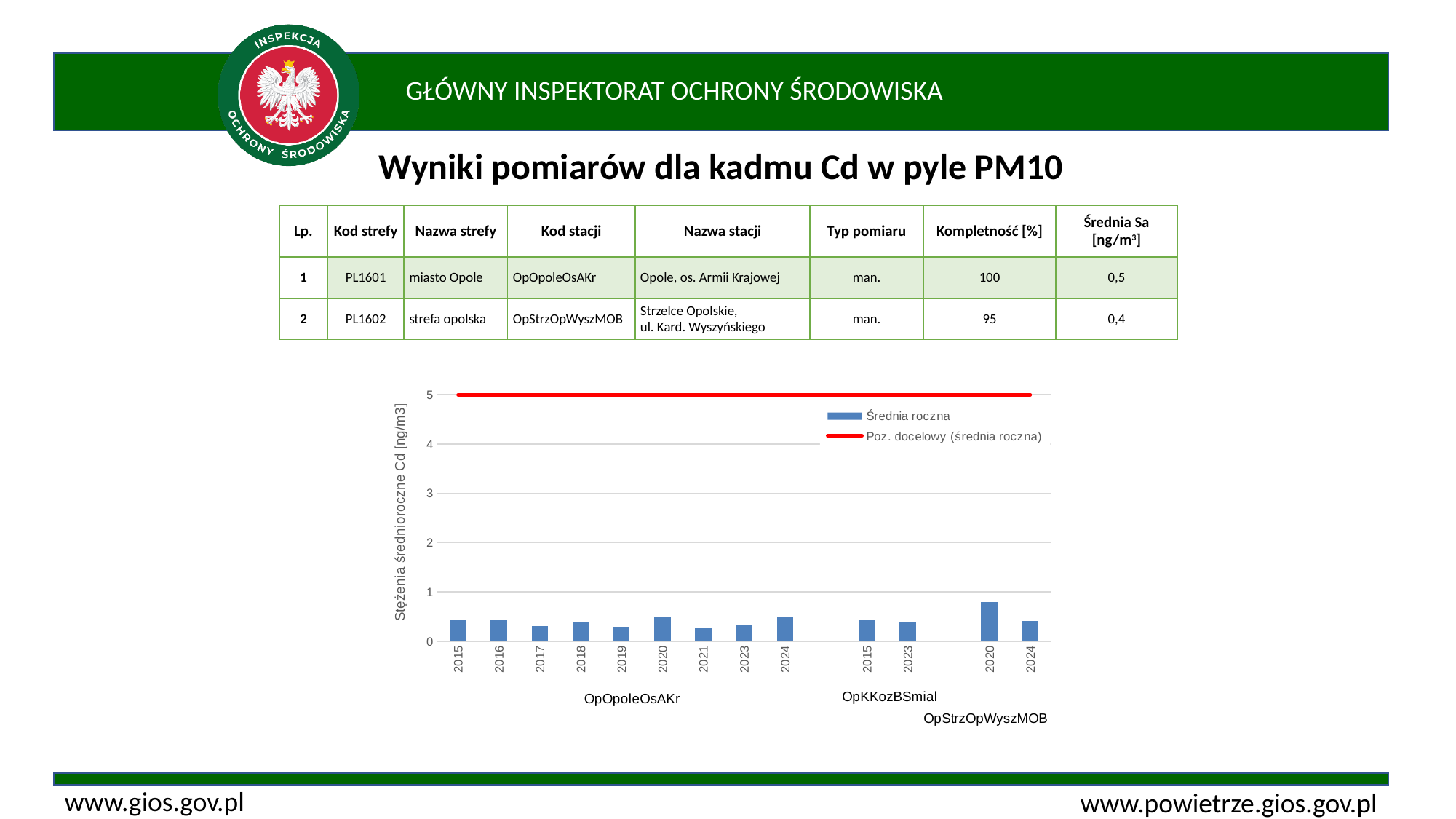
Which station-year has the highest annual mean bar in the chart? OpStrzOpWyszMOB 2020 For station OpOpoleOsAKr, which year has the larger annual mean, 2020 or 2021? 2020 For station OpStrzOpWyszMOB, which year has the larger annual mean, 2020 or 2024? 2020 What kind of chart is shown on the slide? combination bar and line chart What are the two entries in the chart legend? Średnia roczna; Poz. docelowy (średnia roczna) How many series does the chart legend list? 2 How many years are plotted for station OpOpoleOsAKr? 9 Is the annual mean for OpOpoleOsAKr in 2024 greater or less than 1? less At what value on the vertical axis does the red Poz. docelowy line sit? 5 How many bars (station-year points) are plotted in the chart? 13 What is the label of the vertical axis of the chart? Stężenia średnioroczne Cd [ng/m3] Is the annual mean for OpStrzOpWyszMOB in 2020 greater or less than 1? less